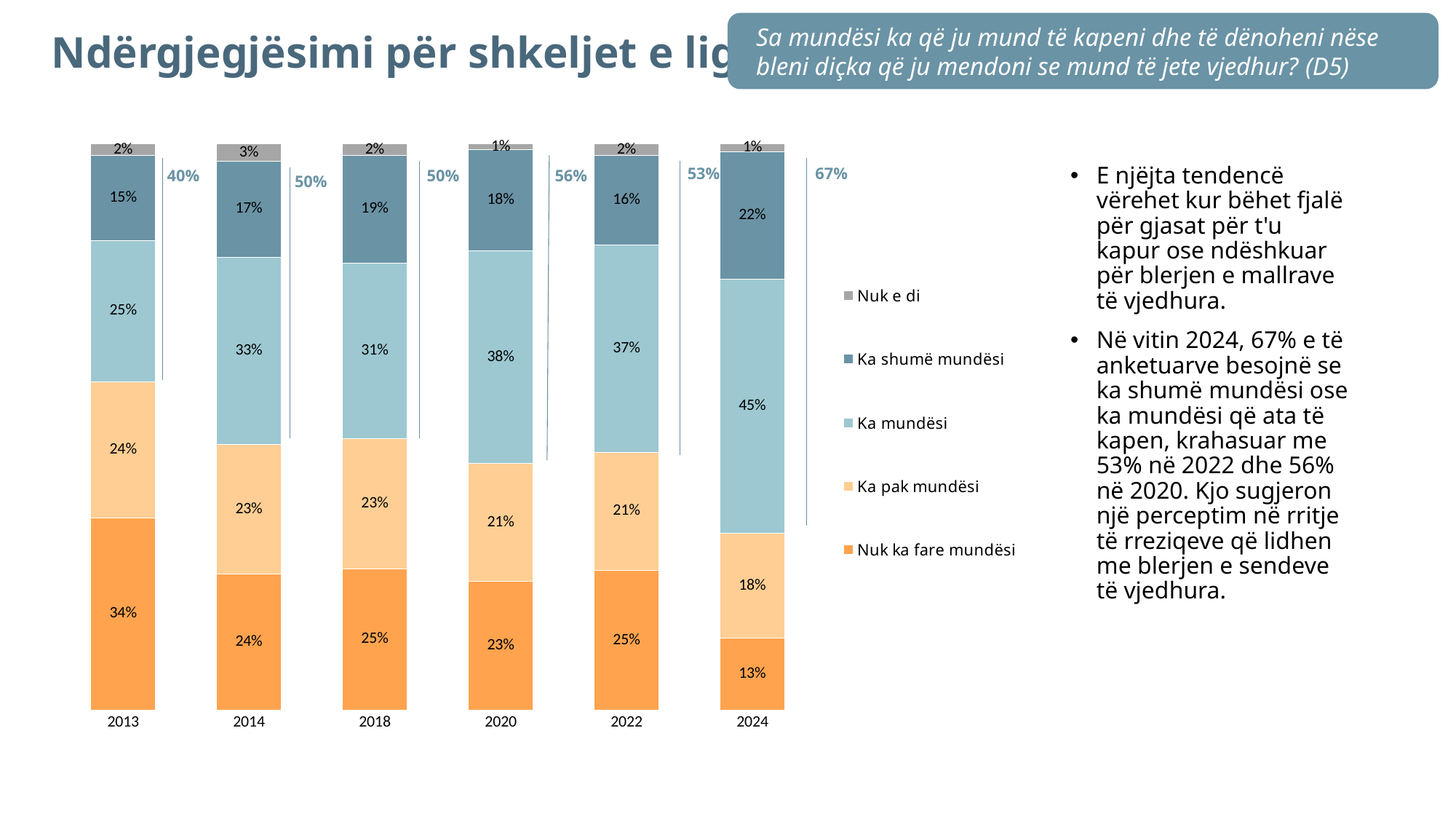
What combined percentage is shown beside the 2024 bar for "Ka shumë mundësi" and "Ka mundësi"? 67% What is the difference between the "Ka shumë mundësi" values in 2024 and 2022? 6% What is the value for "Nuk ka fare mundësi" in 2013? 34% How many series does the legend list? 5 In which year is the "Ka mundësi" value the highest? 2024 What is the value for "Ka shumë mundësi" in 2020? 18% What kind of chart is shown on the slide? Stacked bar chart Which is larger: the "Ka pak mundësi" value in 2013 or in 2024? 2013 In which year is the "Nuk ka fare mundësi" value the lowest? 2024 What is the value for "Ka pak mundësi" in 2022? 21% What is the value for "Ka mundësi" in 2024? 45% How many years are shown on the x axis? 6